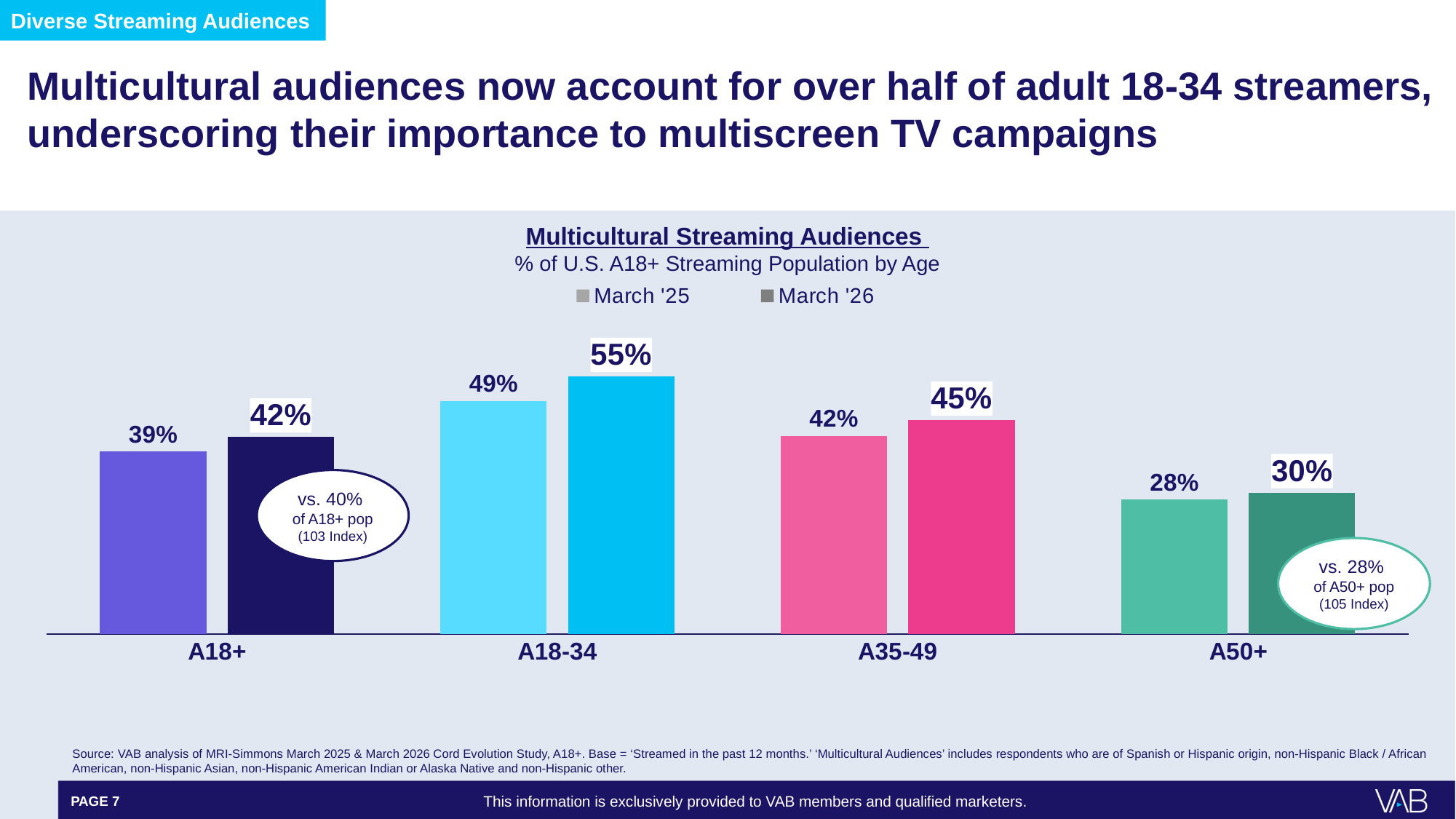
How many age groups are shown on the x axis? 4 What is the March '25 value for A35-49? 42% What is the March '25 value for A50+? 28% How many series does the legend list? 2 What is the March '26 value for A18-34? 55% What is the March '26 value for A18+? 42% What is the difference between the March '26 and March '25 values for A18-34? 6% What kind of chart is shown on the slide? Bar chart Which age group has the lowest March '25 value? A50+ Which is larger, the March '26 value for A35-49 or the March '26 value for A50+? March '26 value for A35-49 Which age group has the highest March '26 value? A18-34 What is the difference between the March '26 and March '25 values for A35-49? 3%